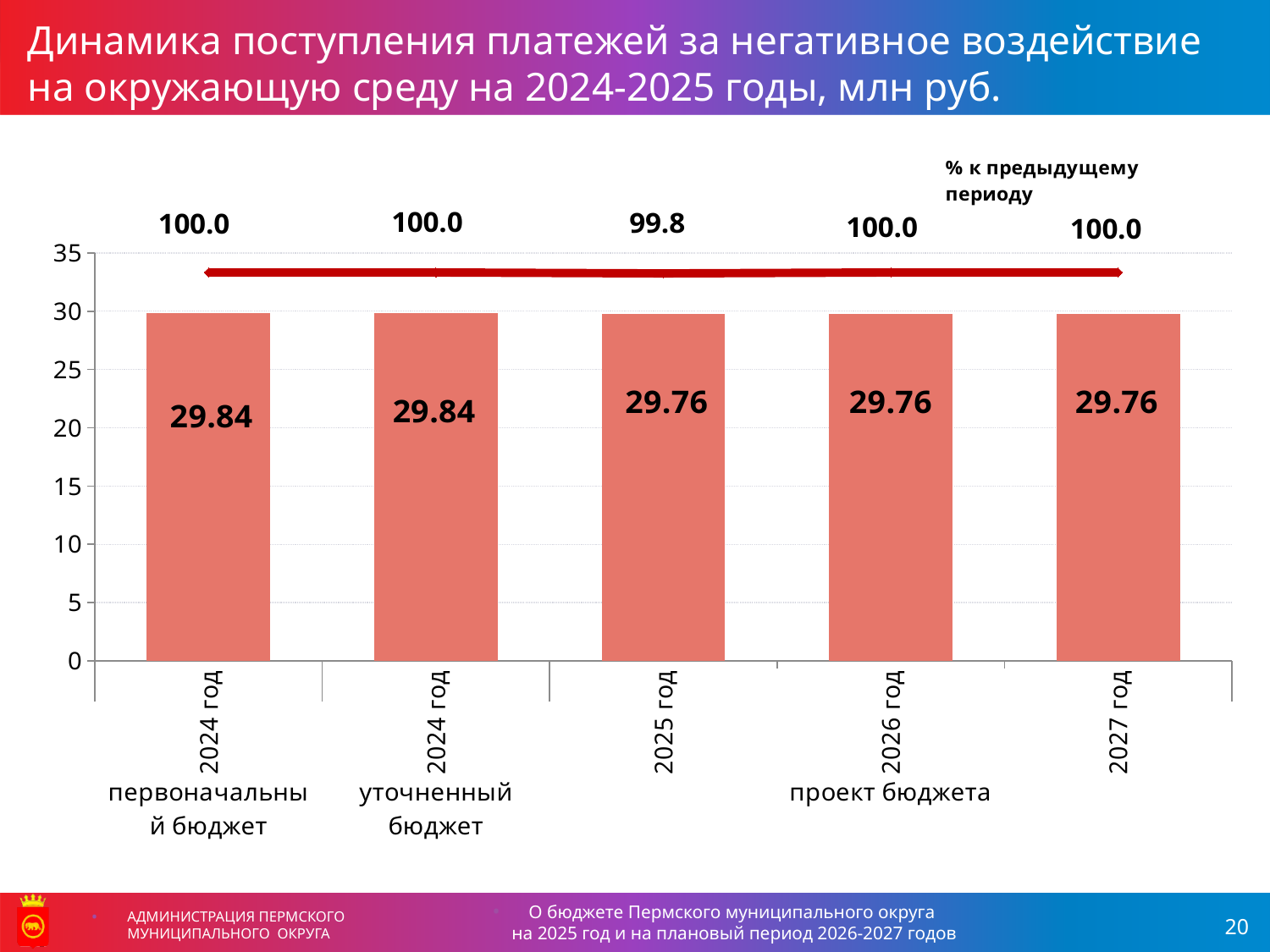
What is the value for 2025 год? 29.76 How many bars are plotted in the chart? 5 Is the value for 2026 год greater or less than 25? greater Which is larger, the value for 2024 год (уточненный бюджет) or the value for 2026 год? 2024 год (уточненный бюджет) What is the unit of measurement stated in the chart title? млн руб. Do the bar values rise or fall from 2024 год (уточненный бюджет) to 2025 год? fall What kind of chart is shown on the slide? combination bar and line chart What is the '% к предыдущему периоду' value shown above the 2026 год bar? 100.0 What is the value for 2027 год? 29.76 What is the value for 2024 год (первоначальный бюджет)? 29.84 What is the '% к предыдущему периоду' value shown above the 2025 год bar? 99.8 What is the difference between the value for 2024 год (уточненный бюджет) and the value for 2025 год? 0.08